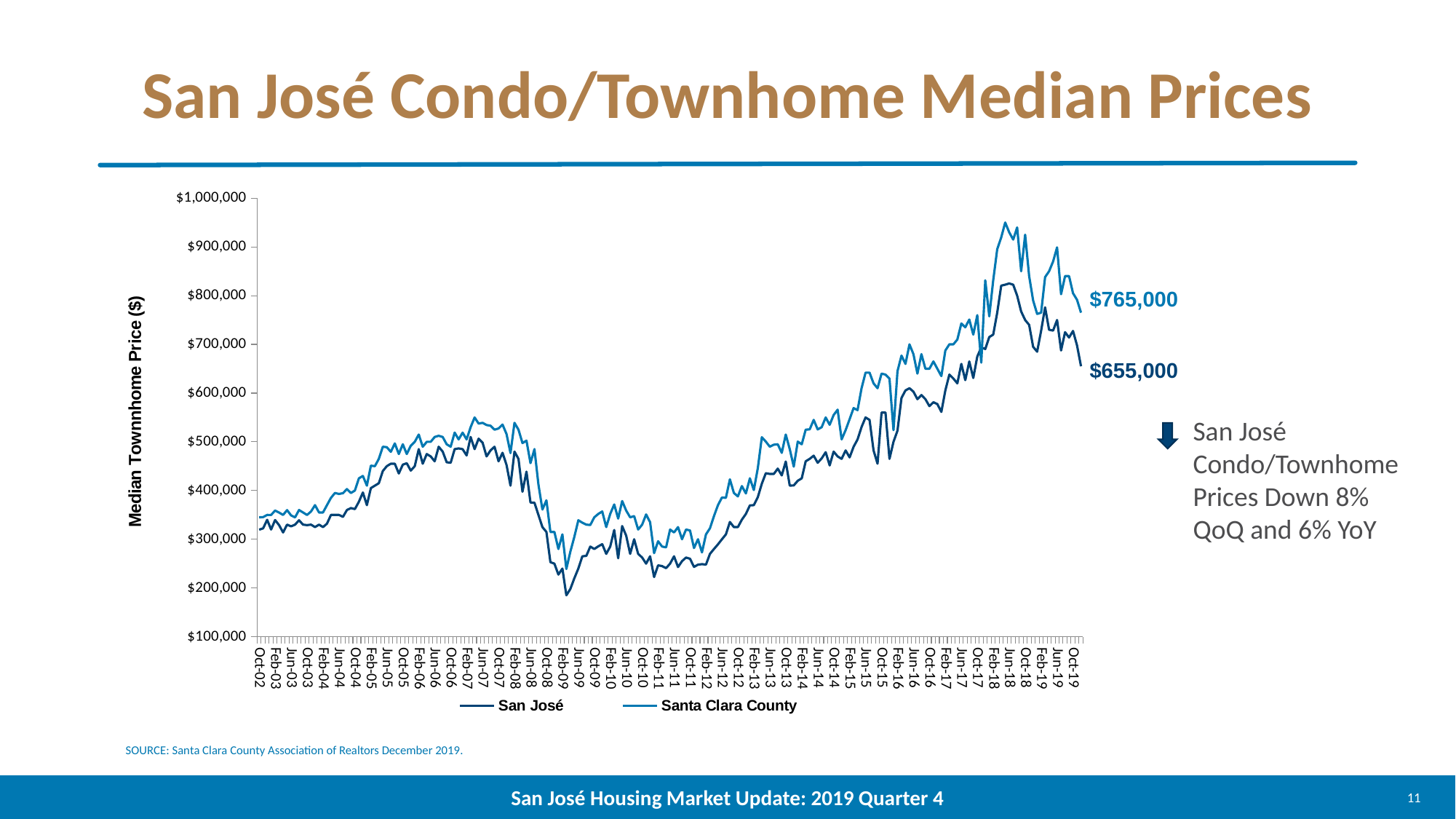
What kind of chart is shown on the slide? line chart How many series does the legend list? 2 Does the San José line rise or fall between Jun-07 and Feb-09? fall What is the latest (Oct-19) median price labelled for Santa Clara County? $765,000 What is the latest (Oct-19) median price labelled for San José? $655,000 According to the annotation on the slide, by what percentage are San José condo/townhome prices down quarter over quarter? 8% Does the San José line rise or fall between Feb-12 and Jun-18? rise Is the peak of the Santa Clara County line around Jun-18 greater or less than $900,000? greater What are the two series named in the legend? San José and Santa Clara County At the end of the chart, which series has the higher median price, San José or Santa Clara County? Santa Clara County Is the San José median price at Oct-02 greater or less than $400,000? less What is the difference between the labelled Santa Clara County value ($765,000) and the labelled San José value ($655,000)? $110,000